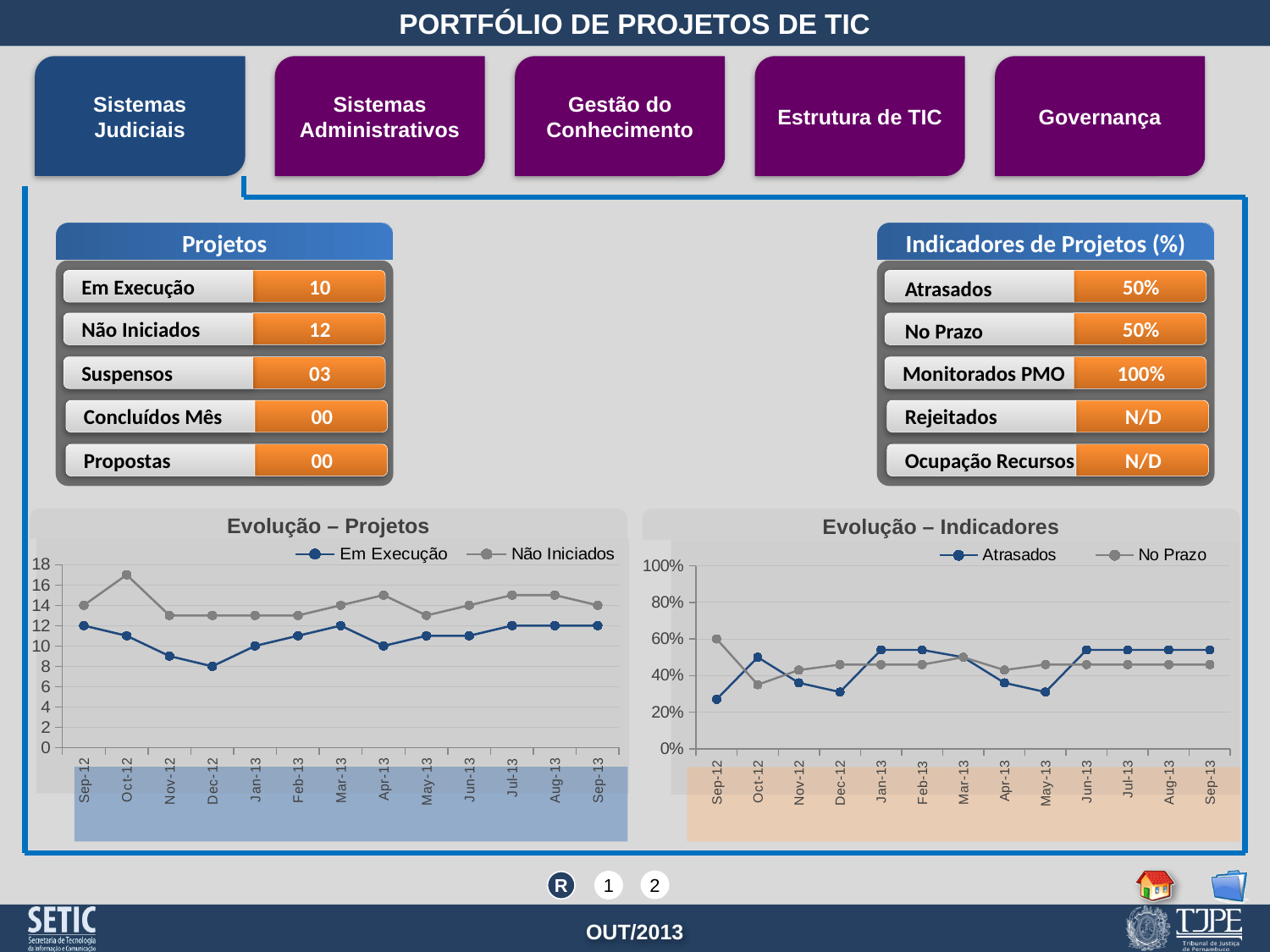
How many series does the legend of the "Evolução – Projetos" chart list? 2 How many series does the legend of the "Evolução – Indicadores" chart list? 2 In the "Evolução – Projetos" chart, which series has the higher value in Sep-12, Em Execução or Não Iniciados? Não Iniciados In the "Evolução – Projetos" chart, what is the Em Execução value for Dec-12? 8 In the "Evolução – Projetos" chart, in which month is the Não Iniciados series highest? Oct-12 In the "Evolução – Projetos" chart, is the Não Iniciados value for Oct-12 greater or less than 16? greater How many months are plotted along the x axis of the "Evolução – Projetos" chart? 13 In the "Evolução – Indicadores" chart, is the Atrasados value for Sep-12 greater or less than 40%? less What kind of chart is the "Evolução – Projetos" chart? Line chart What are the two legend entries of the "Evolução – Indicadores" chart? Atrasados and No Prazo In the "Evolução – Projetos" chart, in which month is the Em Execução series lowest? Dec-12 In the "Evolução – Projetos" chart, does the Em Execução series rise or fall from Sep-12 to Dec-12? Fall